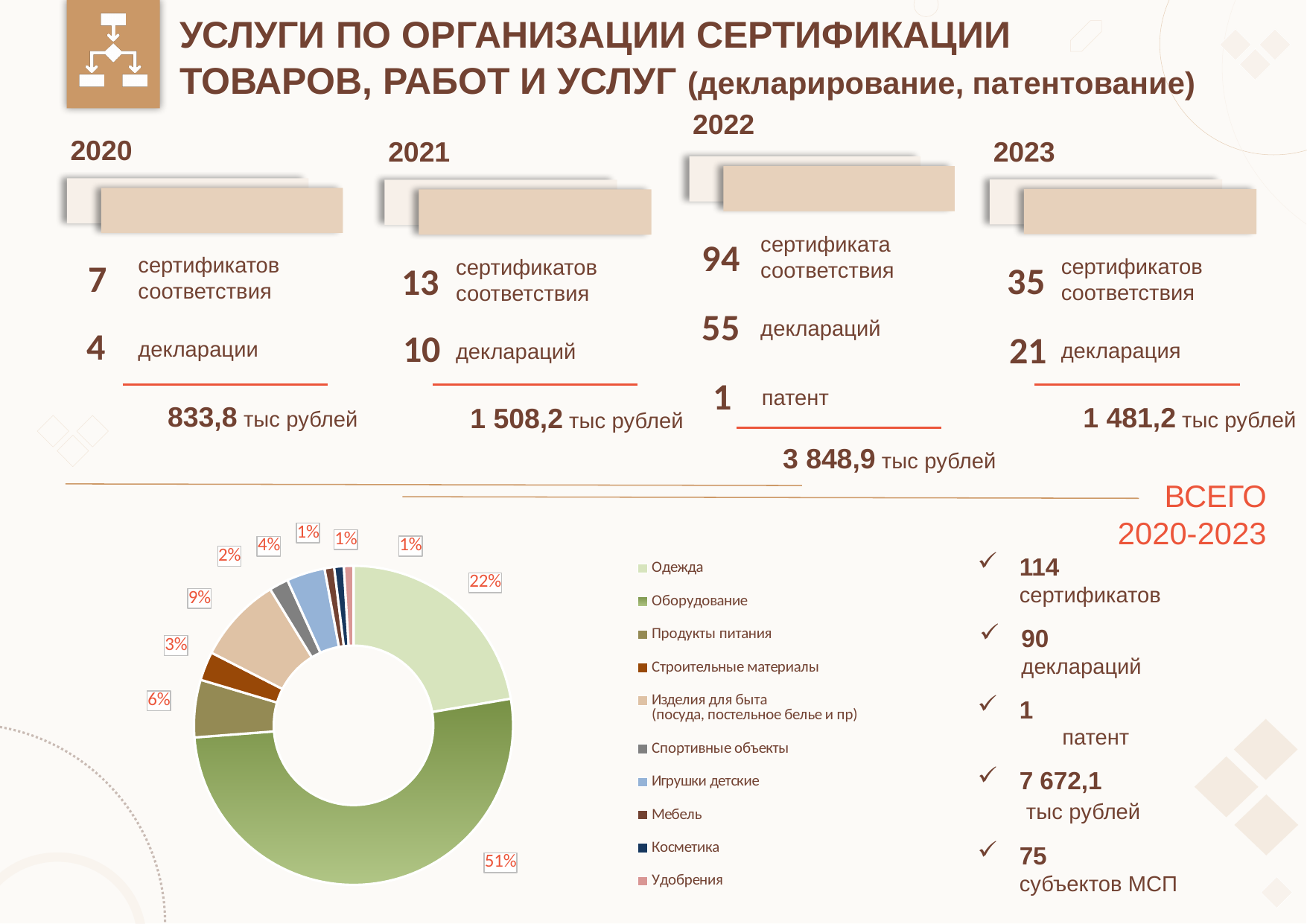
What is the value shown for Изделия для быта in the doughnut chart? 9% What is the value shown for Продукты питания in the doughnut chart? 6% How many categories are listed in the legend of the doughnut chart? 10 What share of the doughnut chart does Оборудование account for? 51% Which has the larger share in the doughnut chart, Изделия для быта or Продукты питания? Изделия для быта By how many percentage points does the share of Оборудование exceed the share of Одежда? 29 percentage points What is the value shown for Спортивные объекты in the doughnut chart? 2% What share of the doughnut chart does Одежда account for? 22% What is the value shown for Строительные материалы in the doughnut chart? 3% What is the value shown for Игрушки детские in the doughnut chart? 4% What kind of chart is shown on the slide? Doughnut (pie) chart Which category has the largest share in the doughnut chart? Оборудование